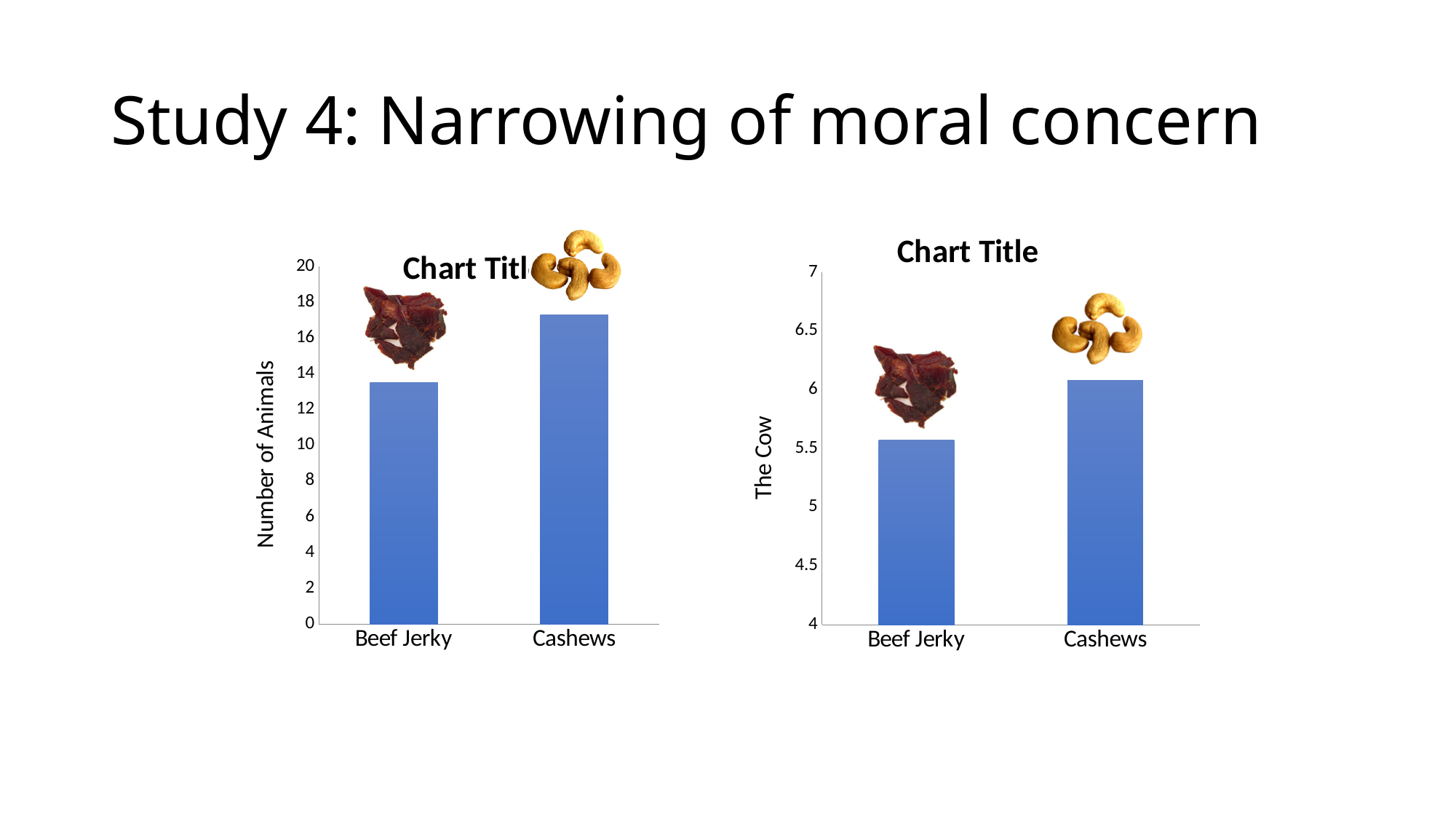
How many categories are shown on the left chart (y-axis 'Number of Animals')? 2 On the right chart (y-axis 'The Cow'), do the values rise or fall from Beef Jerky to Cashews? rise On the right chart (y-axis 'The Cow'), which category has the higher value, Beef Jerky or Cashews? Cashews What type of chart is the left chart with the y-axis labelled 'Number of Animals'? bar chart On the left chart (y-axis 'Number of Animals'), which category has the lowest value? Beef Jerky On the left chart (y-axis 'Number of Animals'), which category has the highest value? Cashews What is the y-axis title of the left chart? Number of Animals On the left chart (y-axis 'Number of Animals'), is the value for Beef Jerky greater or less than 14? less On the right chart (y-axis 'The Cow'), is the value for Beef Jerky greater or less than 6? less What is the y-axis title of the right chart? The Cow On the left chart (y-axis 'Number of Animals'), is the value for Cashews greater or less than 16? greater